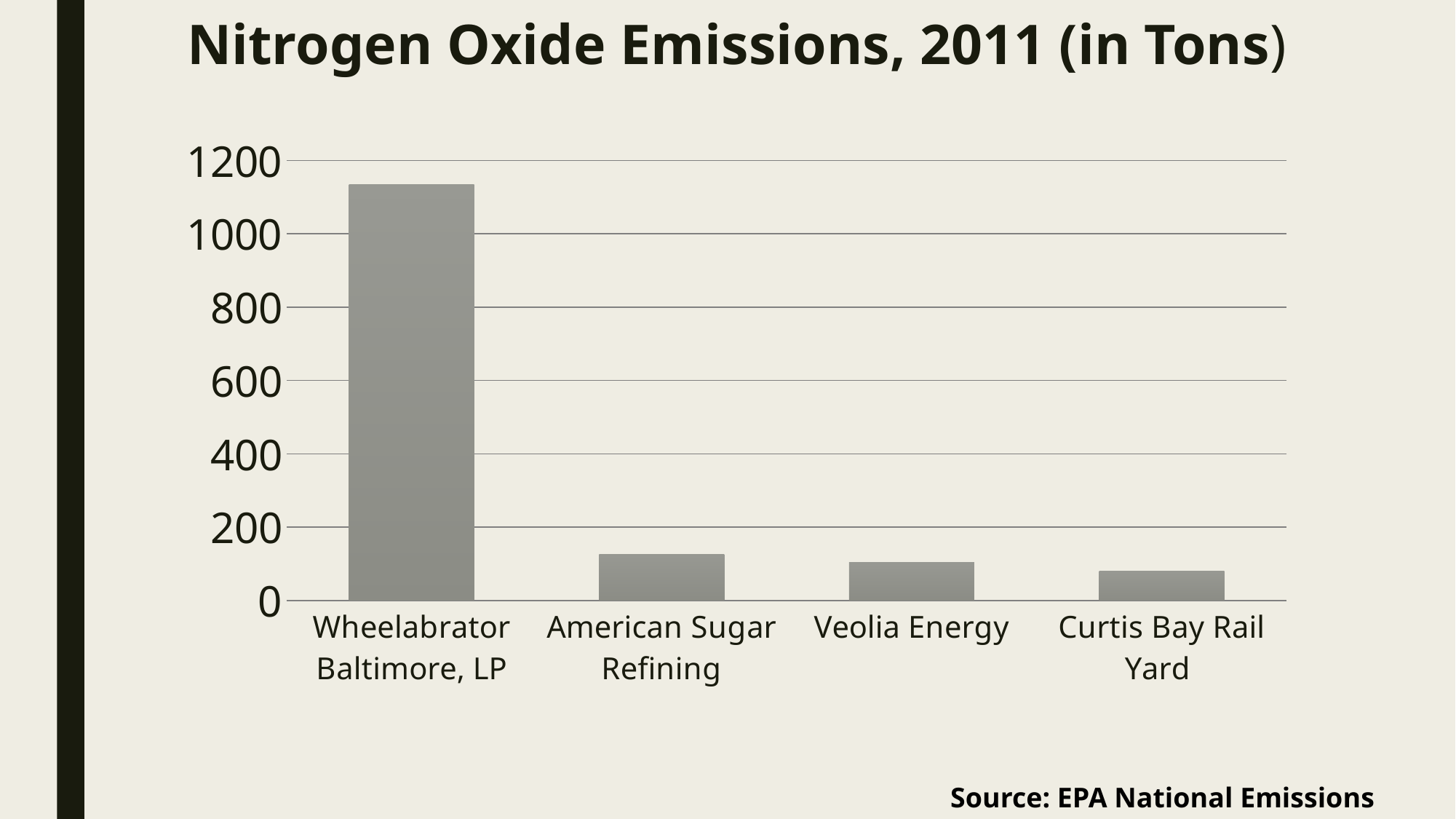
Which facility has the highest nitrogen oxide emissions? Wheelabrator Baltimore, LP Which has higher emissions, American Sugar Refining or Curtis Bay Rail Yard? American Sugar Refining Is the value for Veolia Energy greater or less than 200? less How many facilities (categories) are shown on the chart? 4 Is the value for Curtis Bay Rail Yard greater or less than 200? less Which facility has the lowest nitrogen oxide emissions? Curtis Bay Rail Yard Is the value for Wheelabrator Baltimore, LP greater or less than 1000? greater What is the source cited for the chart data? EPA National Emissions What is the title of the chart? Nitrogen Oxide Emissions, 2011 (in Tons) What kind of chart is shown on the slide? bar chart